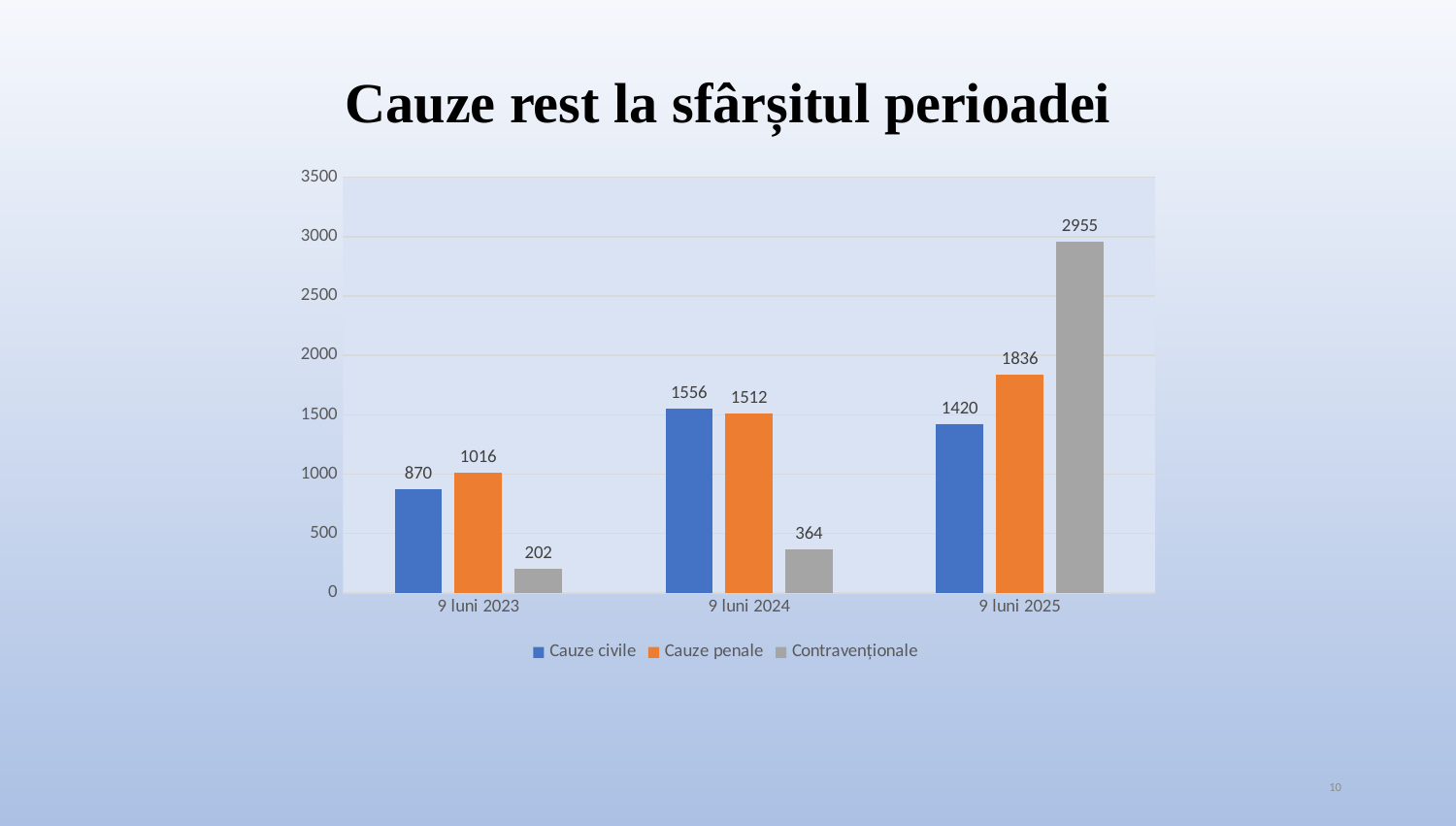
Which period has the lowest value for Cauze civile? 9 luni 2023 What is the value for Contravenționale in 9 luni 2025? 2955 What is the value for Cauze penale in 9 luni 2023? 1016 Do the values for Contravenționale rise or fall from 9 luni 2023 to 9 luni 2025? rise How many series does the legend list? 3 How many periods are shown on the x axis? 3 Which period has the highest value for Contravenționale? 9 luni 2025 What is the value for Cauze civile in 9 luni 2024? 1556 What is the difference between Cauze penale in 9 luni 2025 and 9 luni 2024? 324 What kind of chart is shown on the slide? bar chart Is the value for Contravenționale in 9 luni 2023 greater or less than 500? less Which is larger in 9 luni 2024: Cauze civile or Cauze penale? Cauze civile